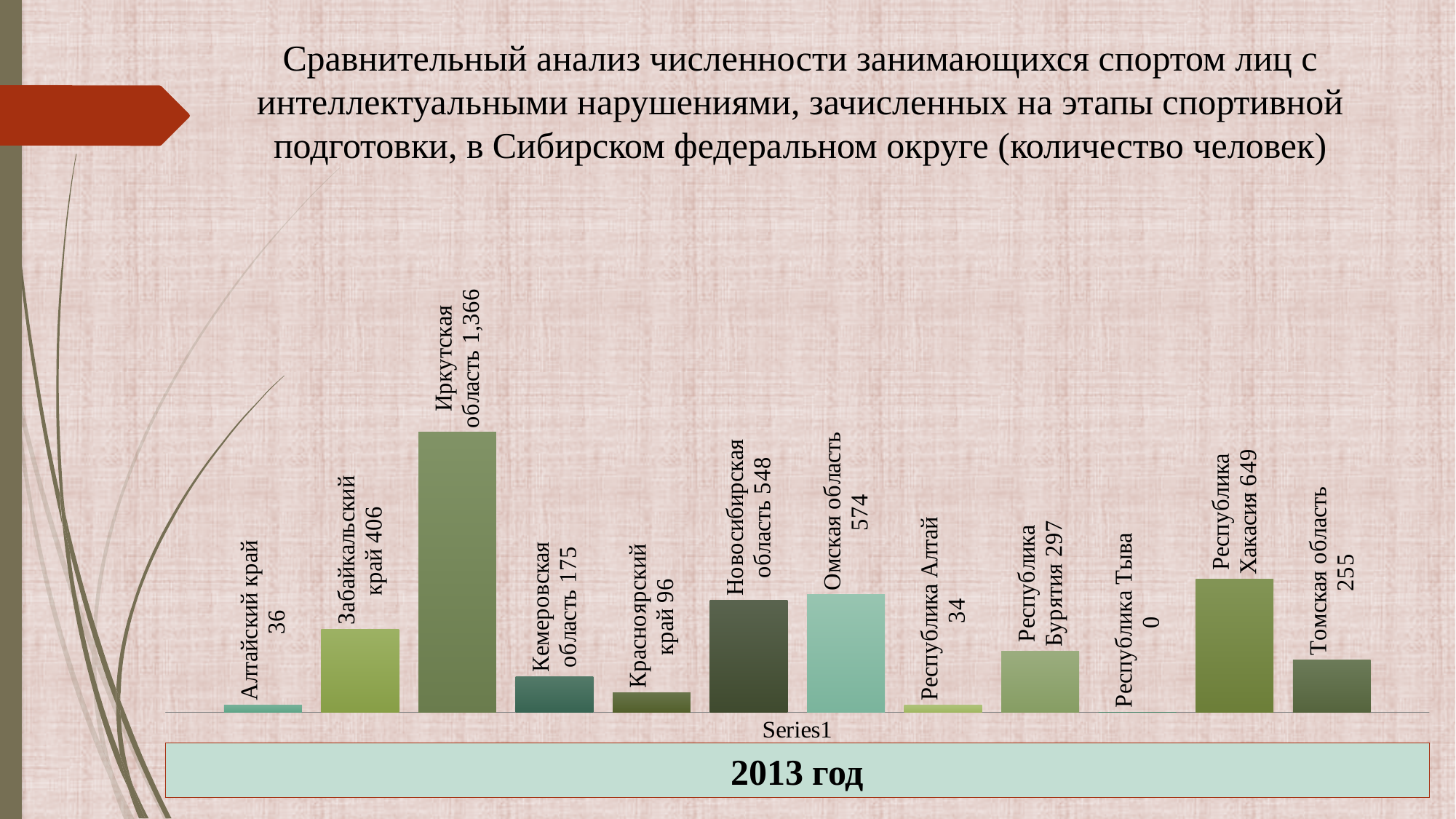
Which region has the highest value? Иркутская область What is the value for Республика Тыва? 0 What year is indicated in the label below the chart? 2013 год What is the value for Республика Хакасия? 649 What is the difference between the values for Забайкальский край and Республика Бурятия? 109 Which region has the lowest value? Республика Тыва How many regions are shown in the chart? 12 What is the difference between the values for Омская область and Новосибирская область? 26 Which is larger, the value for Томская область or the value for Красноярский край? Томская область What kind of chart is shown on the slide? Bar chart What is the value for Иркутская область? 1,366 What is the value for Кемеровская область? 175